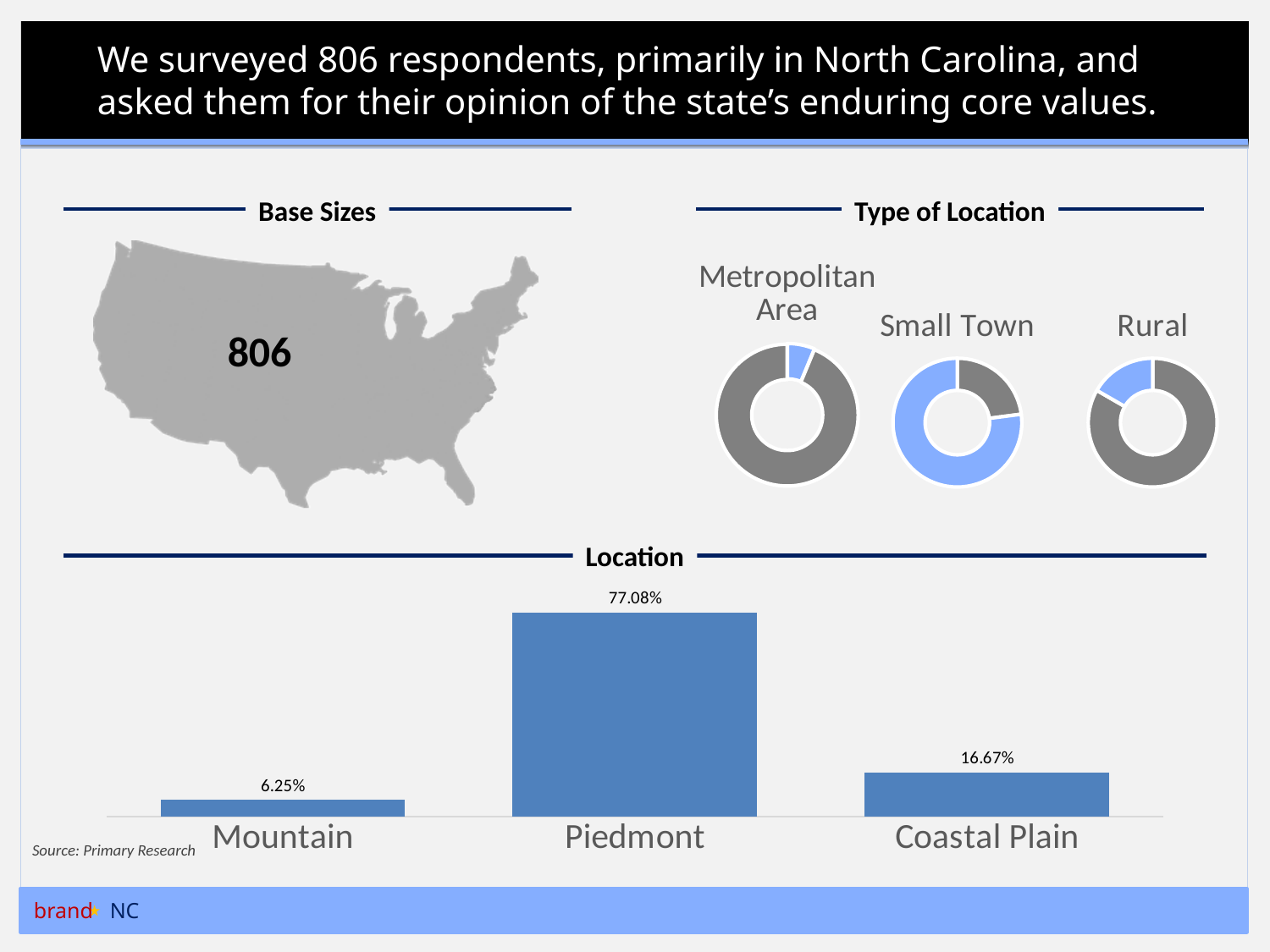
In the Location chart, what is the difference between the values for Piedmont and Coastal Plain? 60.41% Among the three Type of Location donut charts, which one has the smallest blue share? Metropolitan Area In the Location chart, what is the value for Mountain? 6.25% In the Location chart, what is the value for Piedmont? 77.08% How many categories are shown in the Location chart? 3 In the Location chart, what is the value for Coastal Plain? 16.67% In the Location chart, which is larger, the value for Coastal Plain or the value for Mountain? Coastal Plain Among the three Type of Location donut charts, which one has the largest blue share? Small Town In the Location chart, what is the difference between the values for Coastal Plain and Mountain? 10.42% In the Location chart, which category has the highest value? Piedmont What kind of chart is the Location chart? bar chart In the Location chart, which category has the lowest value? Mountain